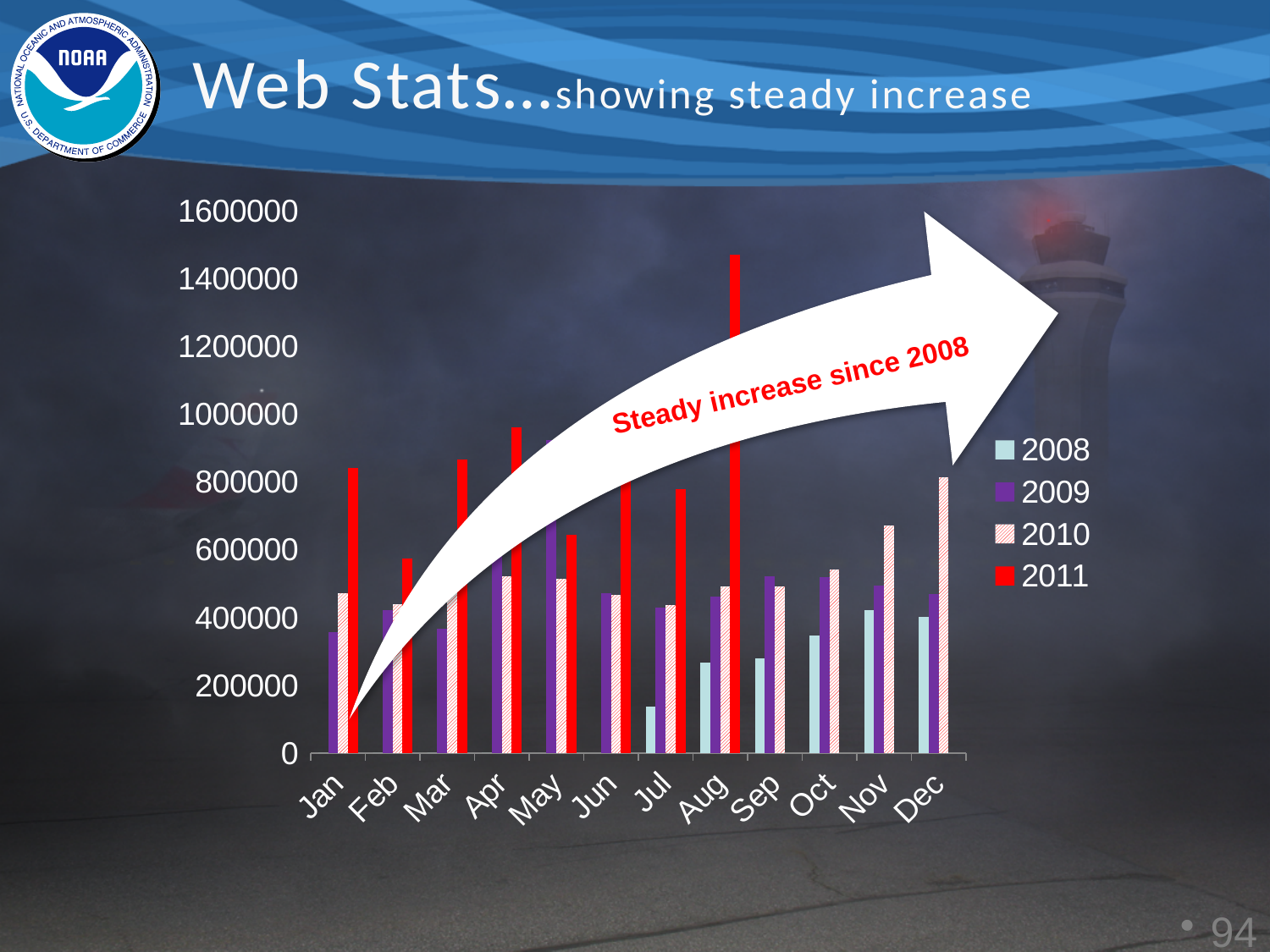
In which month is the 2008 bar the lowest? Jul Is the 2010 value for Nov greater or less than 600000? greater Is the 2011 value for Aug greater or less than 1400000? greater In which month is the 2011 bar the highest? Aug Which series has the tallest bar in Aug? 2011 Is the 2008 value for Jul greater or less than 200000? less How many series does the legend list? 4 What colour are the 2011 bars in the chart? Red Which is larger, the 2011 value for Jan or the 2011 value for Feb? Jan How many months are shown along the x axis? 12 Do the 2010 values rise or fall from Sep to Dec? rise What kind of chart is shown on the slide? Bar chart